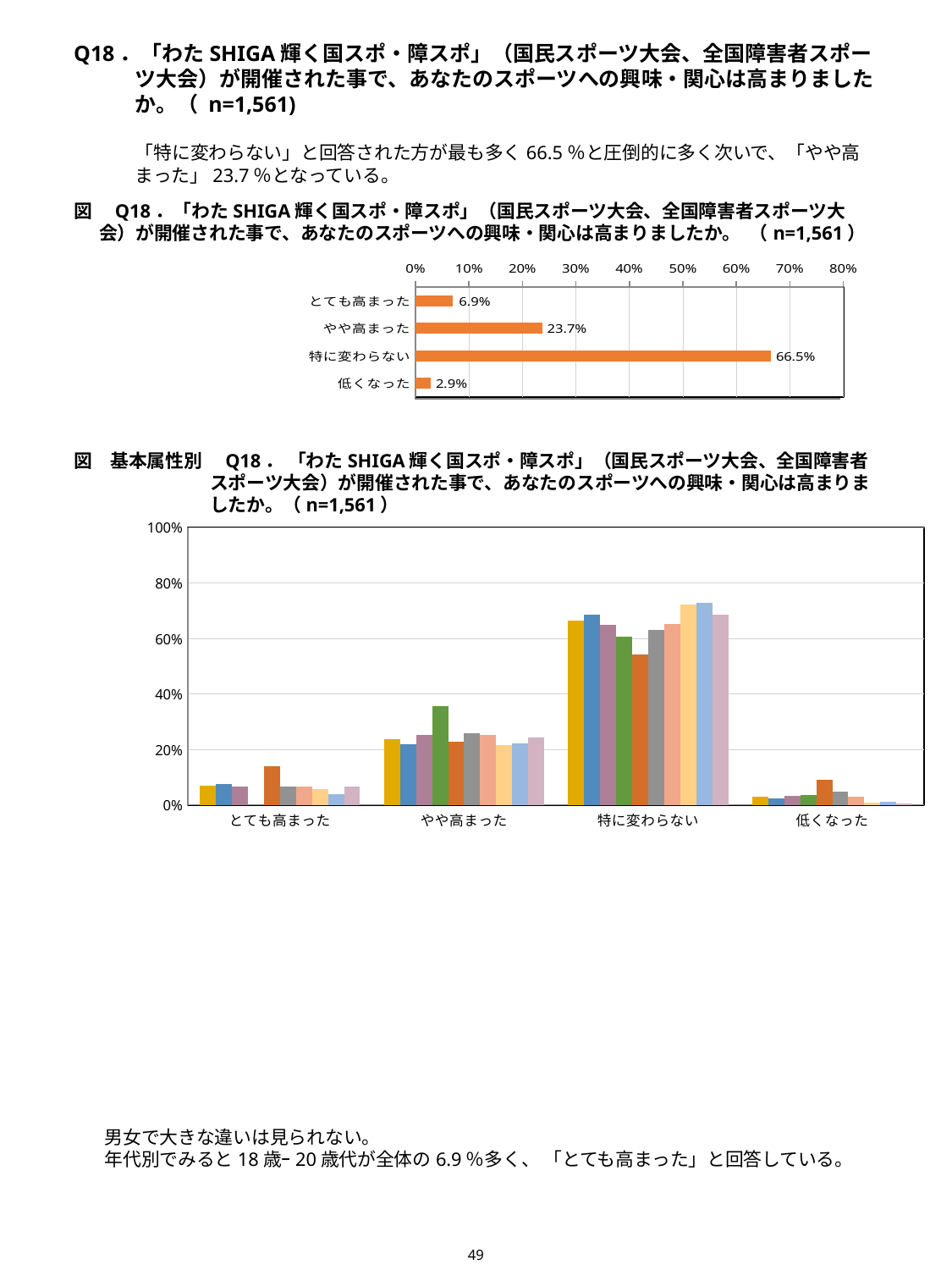
In the upper chart, what is the value for 低くなった? 2.9% In the lower chart (基本属性別), is the tallest bar for やや高まった greater or less than 40%? less What kind of chart is the upper chart? bar chart In the upper chart, what is the value for 特に変わらない? 66.5% In the upper chart, what is the difference between the values for 特に変わらない and やや高まった? 42.8% In the upper chart, which category has the highest value? 特に変わらない In the upper chart, what is the value for とても高まった? 6.9% How many categories does the upper chart show? 4 In the upper chart, which is larger, the value for とても高まった or the value for 低くなった? とても高まった In the upper chart, which category has the lowest value? 低くなった In the lower chart (基本属性別), are all the bars for 特に変わらない greater or less than 40%? greater In the upper chart, what is the value for やや高まった? 23.7%